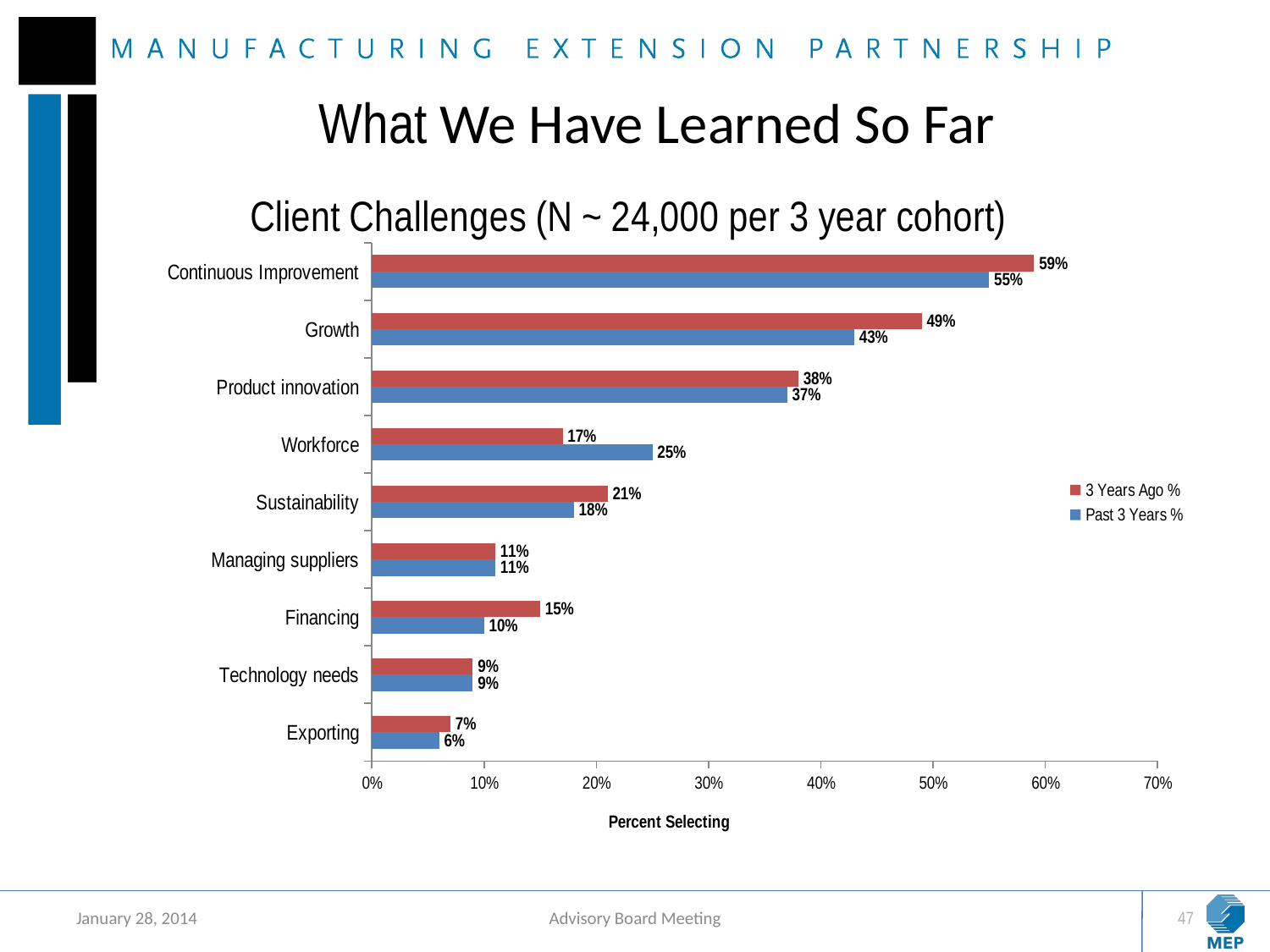
Which category has the lowest value in the 3 Years Ago % series? Exporting What kind of chart is shown on the slide? Bar chart Which is larger for Workforce: the 3 Years Ago % value or the Past 3 Years % value? Past 3 Years % Is the Past 3 Years % value for Product innovation greater or less than 40%? less How many series does the legend list? 2 What is the value for Continuous Improvement in the 3 Years Ago % series? 59% What is the label of the horizontal axis? Percent Selecting How many categories are shown on the chart? 9 What is the value for Workforce in the Past 3 Years % series? 25% What is the value for Financing in the Past 3 Years % series? 10% Which category has the highest value in the Past 3 Years % series? Continuous Improvement What is the difference between the 3 Years Ago % and Past 3 Years % values for Growth? 6%